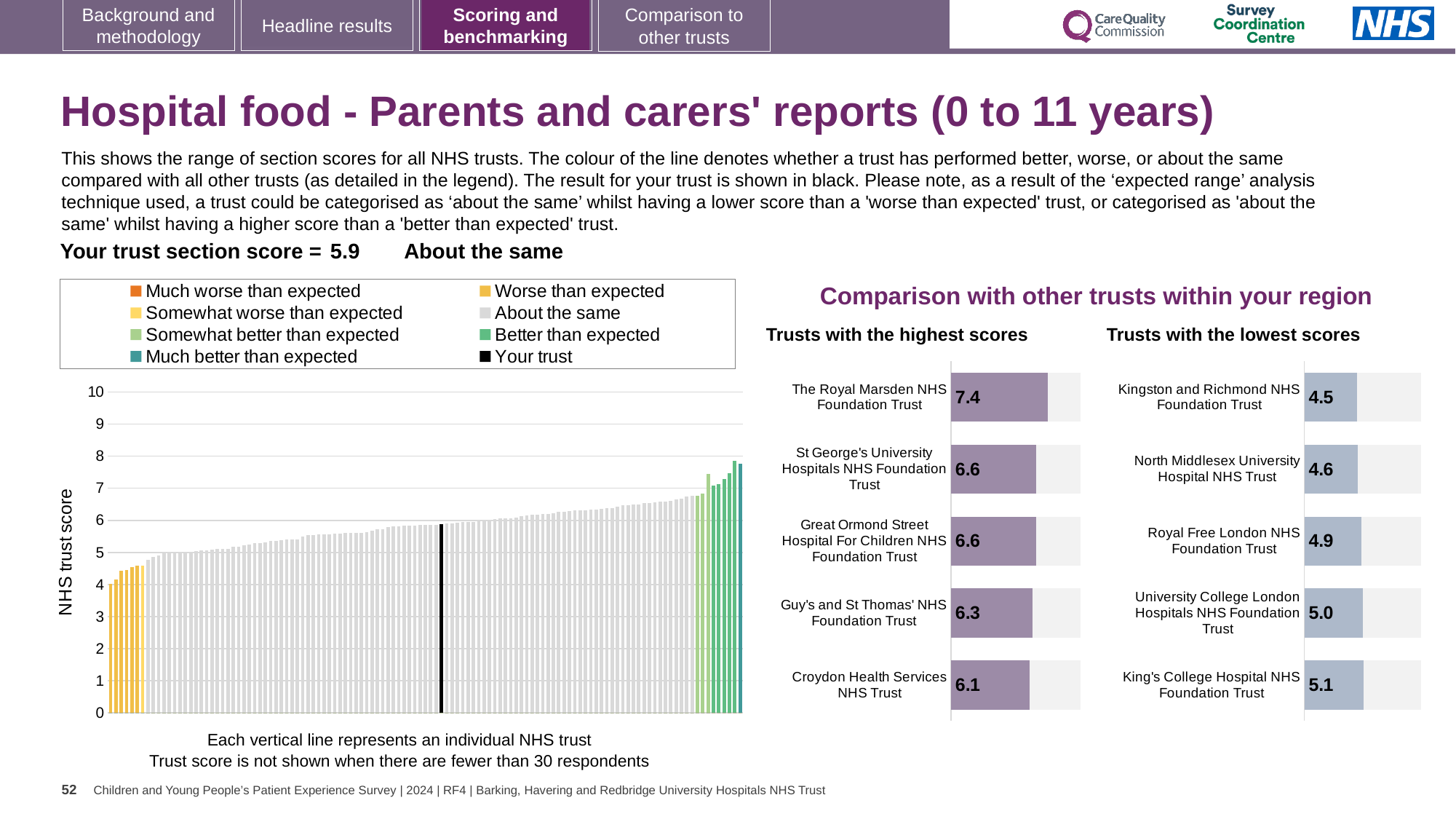
In the main chart of all NHS trusts, is the value of the tallest bar greater or less than 7? greater In the 'Trusts with the lowest scores' chart, which has the larger score: University College London Hospitals NHS Foundation Trust or North Middlesex University Hospital NHS Trust? University College London Hospitals NHS Foundation Trust In the main chart of all NHS trusts, do the bar values rise or fall from left to right? rise In the main chart of all NHS trusts, what is the section score for your trust (the black bar)? 5.9 In the 'Trusts with the highest scores' chart, which trust has the highest score? The Royal Marsden NHS Foundation Trust In the 'Trusts with the lowest scores' chart, what is the score for Royal Free London NHS Foundation Trust? 4.9 What kind of chart is the main chart of all NHS trusts on the left of the slide? bar chart How many entries does the legend above the main chart list? 8 How many trusts are shown in the 'Trusts with the lowest scores' chart? 5 In the 'Trusts with the highest scores' chart, what is the difference between the scores of The Royal Marsden NHS Foundation Trust and Croydon Health Services NHS Trust? 1.3 In the 'Trusts with the lowest scores' chart, which trust has the lowest score? Kingston and Richmond NHS Foundation Trust In the 'Trusts with the highest scores' chart, what is the score for The Royal Marsden NHS Foundation Trust? 7.4